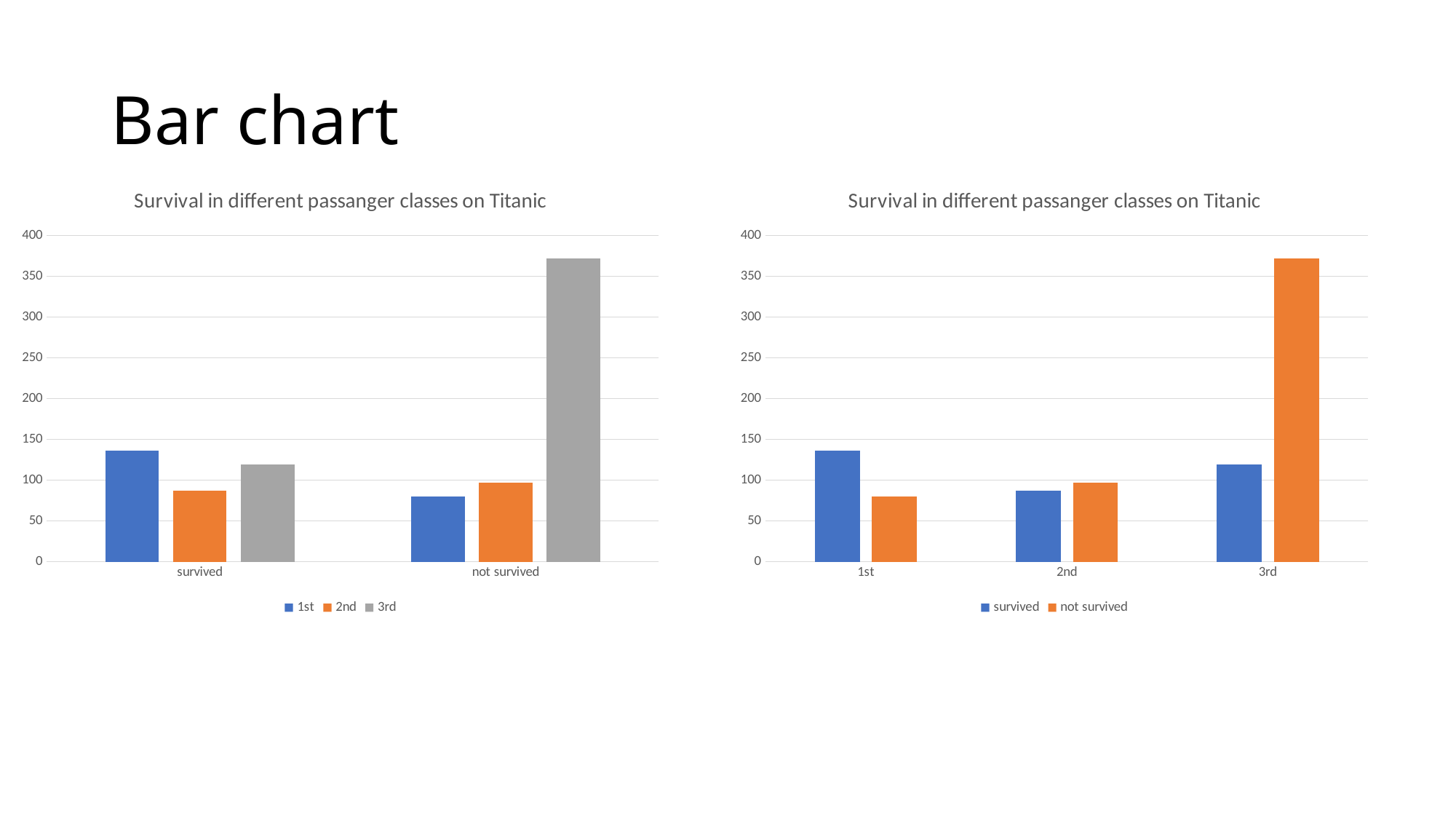
In the right chart, is the 'survived' value for 2nd class greater or less than 100? less In the left chart, which class has the shortest bar in the 'survived' category? 2nd In the left chart, which class has the tallest bar in the 'not survived' category? 3rd What is the title of the chart on the right of the slide? Survival in different passanger classes on Titanic In the right chart, is the 'survived' value for 1st class greater or less than 100? greater What kind of chart is the chart on the left of the slide? bar chart In the right chart, for 1st class, which is larger: survived or not survived? survived In the right chart, is the 'not survived' value for 3rd class greater or less than 350? greater How many categories are shown on the x axis of the left chart? 2 How many series does the legend of the left chart list? 3 How many series does the legend of the right chart list? 2 How many categories are shown on the x axis of the right chart? 3